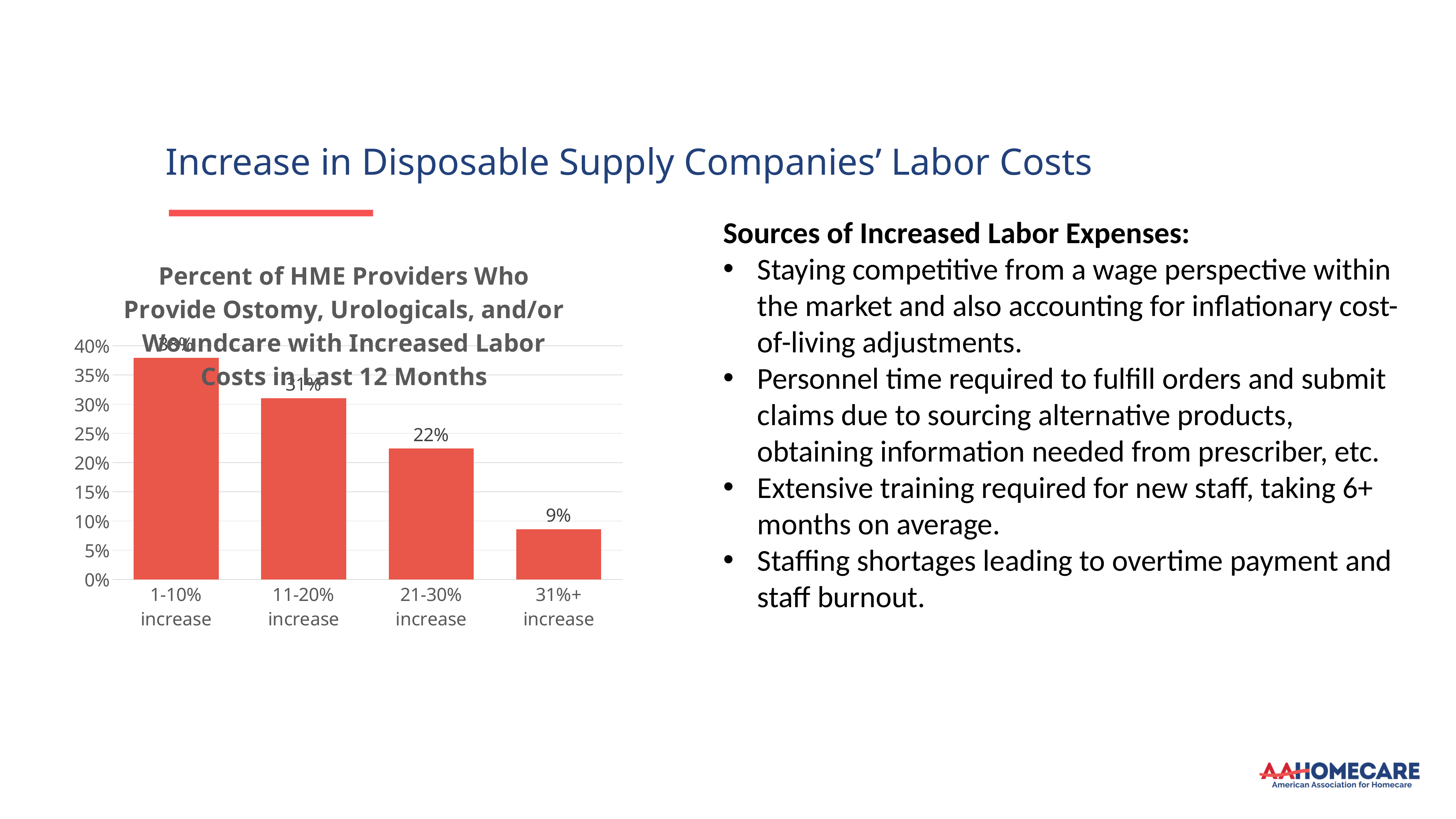
Is the value for 11-20% increase greater or less than 25%? greater Which category has the highest value? 1-10% increase Is the value for 1-10% increase greater or less than 35%? greater Which is larger, the value for 21-30% increase or the value for 31%+ increase? 21-30% increase What colour are the bars in the chart? red What kind of chart is shown on the slide? bar chart What is the difference between the values for 21-30% increase and 31%+ increase? 13% Do the values rise or fall moving from left to right along the x axis? fall How many categories are shown on the x axis of the chart? 4 What is the value for the 31%+ increase category? 9% What is the value for the 21-30% increase category? 22% Which category has the lowest value? 31%+ increase